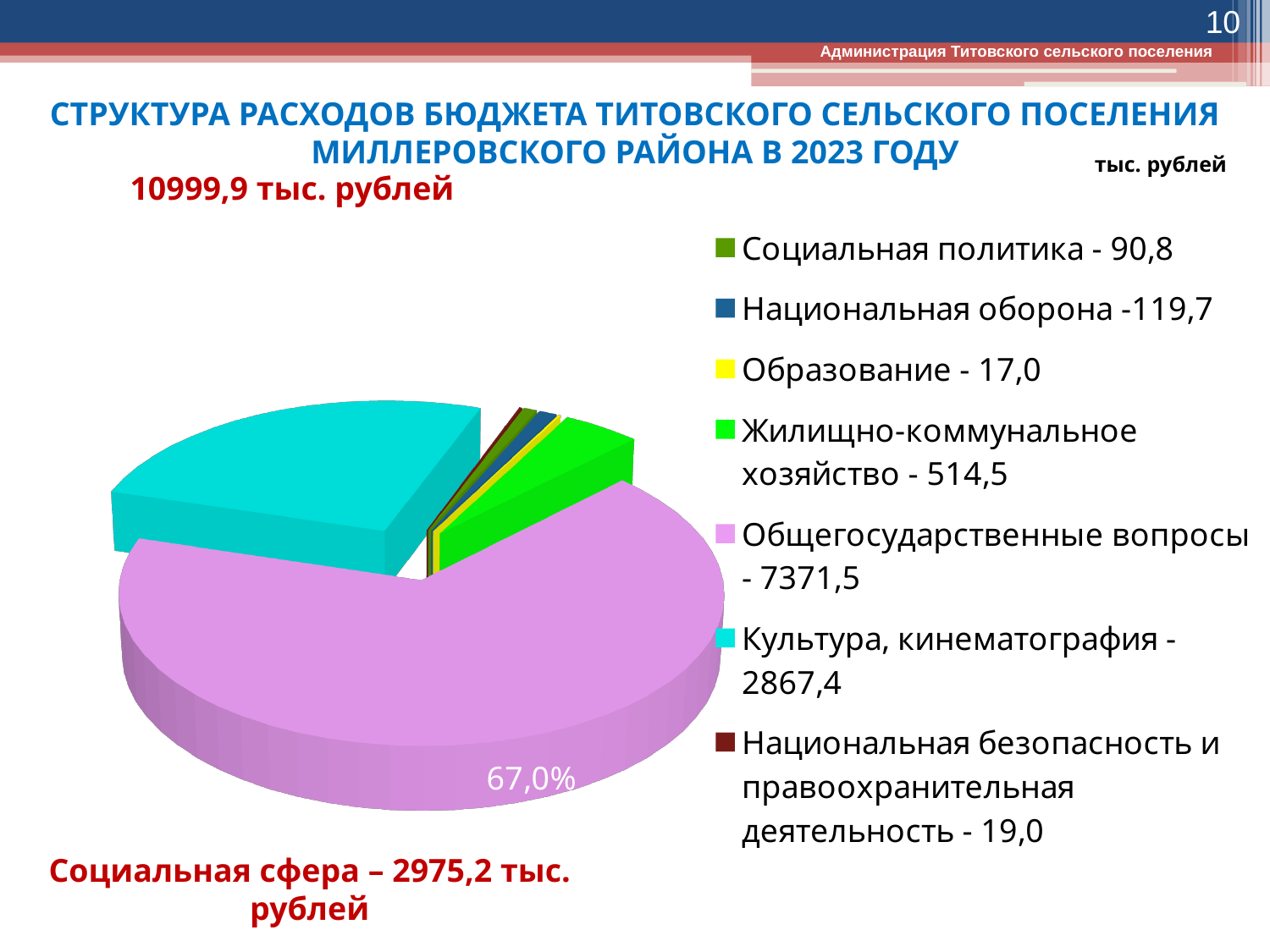
Which category has the smallest value? Образование How many categories does the legend of the pie chart list? 7 Which is larger, Национальная оборона or Социальная политика? Национальная оборона What is the value for Жилищно-коммунальное хозяйство? 514,5 What is the difference between Национальная оборона and Социальная политика? 28,9 What share of the pie does the Общегосударственные вопросы slice represent, as labelled on the chart? 67,0% What total amount of budget expenditure is stated on the slide? 10999,9 тыс. рублей What is the value for Общегосударственные вопросы? 7371,5 What is the value for Культура, кинематография? 2867,4 Which category has the largest value? Общегосударственные вопросы What kind of chart is shown on the slide? pie chart What is the difference between Общегосударственные вопросы and Культура, кинематография? 4504,1